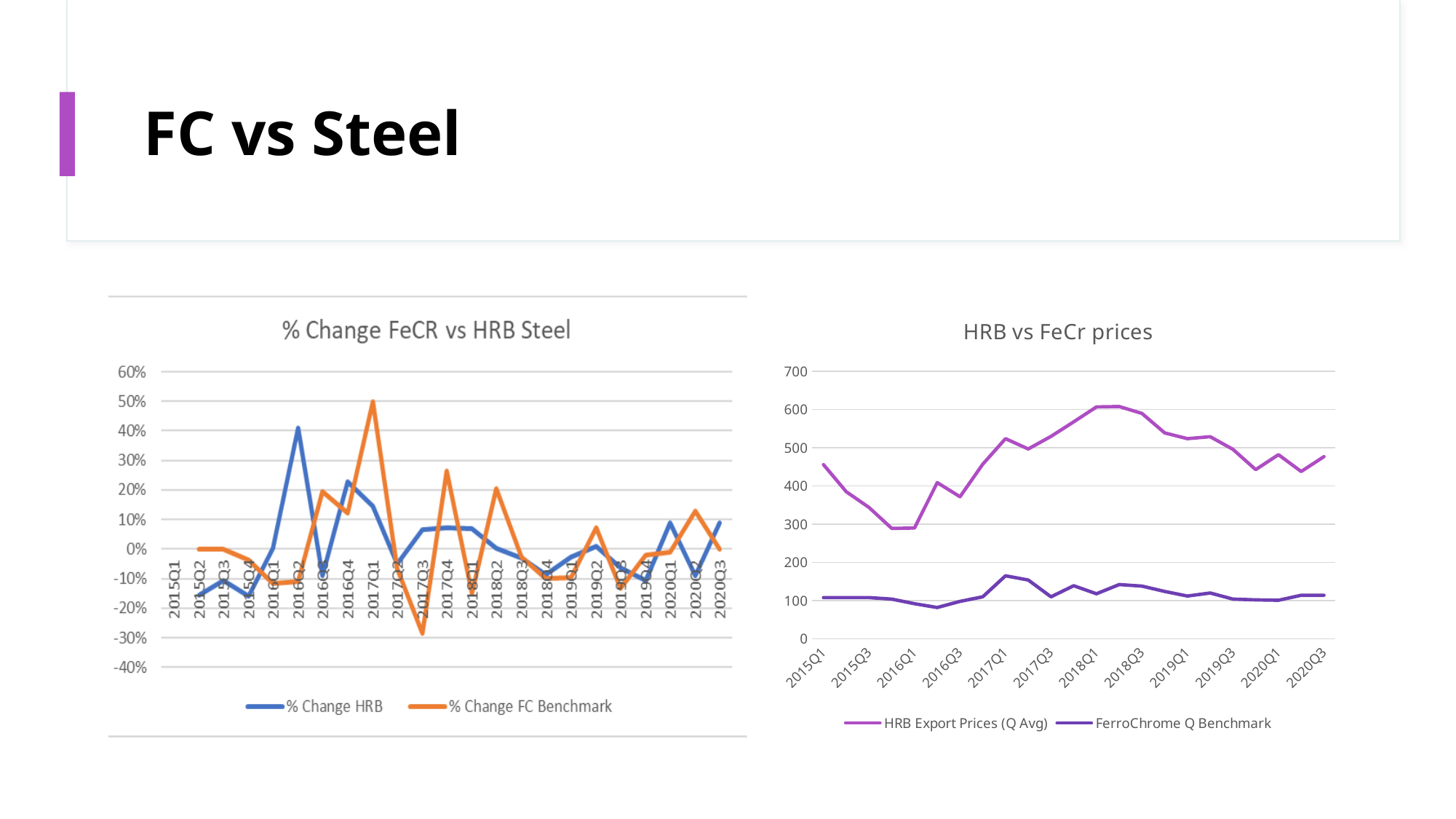
What type of chart is the 'HRB vs FeCr prices' chart? line chart What type of chart is the '% Change FeCR vs HRB Steel' chart? line chart How many series does the legend of the 'HRB vs FeCr prices' chart list? 2 In the '% Change FeCR vs HRB Steel' chart, which series is drawn in orange? % Change FC Benchmark In the '% Change FeCR vs HRB Steel' chart, in which quarter does % Change FC Benchmark reach its lowest value? 2017Q3 In the '% Change FeCR vs HRB Steel' chart, is the value for % Change FC Benchmark at 2017Q1 greater or less than 40%? greater In the 'HRB vs FeCr prices' chart, is the value for FerroChrome Q Benchmark at 2015Q1 greater or less than 200? less In the '% Change FeCR vs HRB Steel' chart, is the value for % Change HRB at 2016Q2 greater or less than 30%? greater In the '% Change FeCR vs HRB Steel' chart, which series reaches the higher peak value? % Change FC Benchmark How many series does the legend of the '% Change FeCR vs HRB Steel' chart list? 2 In the 'HRB vs FeCr prices' chart, do HRB Export Prices (Q Avg) rise or fall from 2015Q1 to 2016Q1? fall